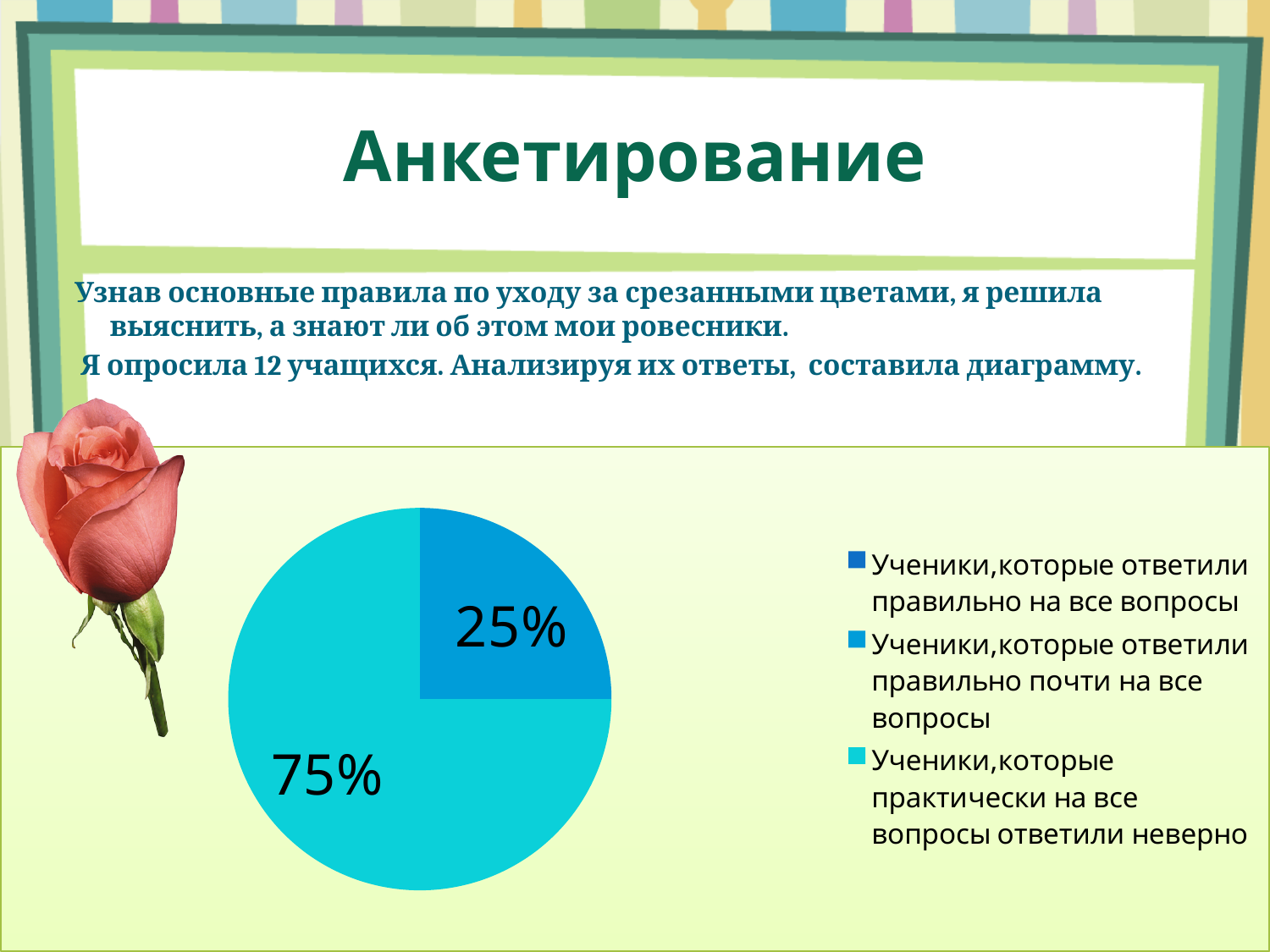
How many slices with printed percentages are visible in the pie chart? 2 What percentage is printed on the smallest slice of the pie chart? 25% What is the difference between the two percentages printed on the pie chart? 50% What is the sum of the two percentages printed on the pie chart? 100% What share of the pie does the light cyan (turquoise) slice take? 75% What is the title of the slide containing the pie chart? Анкетирование What is the last legend entry of the pie chart? Ученики,которые практически на все вопросы ответили неверно How many entries does the legend of the pie chart list? 3 Which slice is larger: the one labelled 75% or the one labelled 25%? 75% What share of the pie does the darker blue slice take? 25% What percentage is printed on the largest slice of the pie chart? 75% What kind of chart is shown on the slide? pie chart